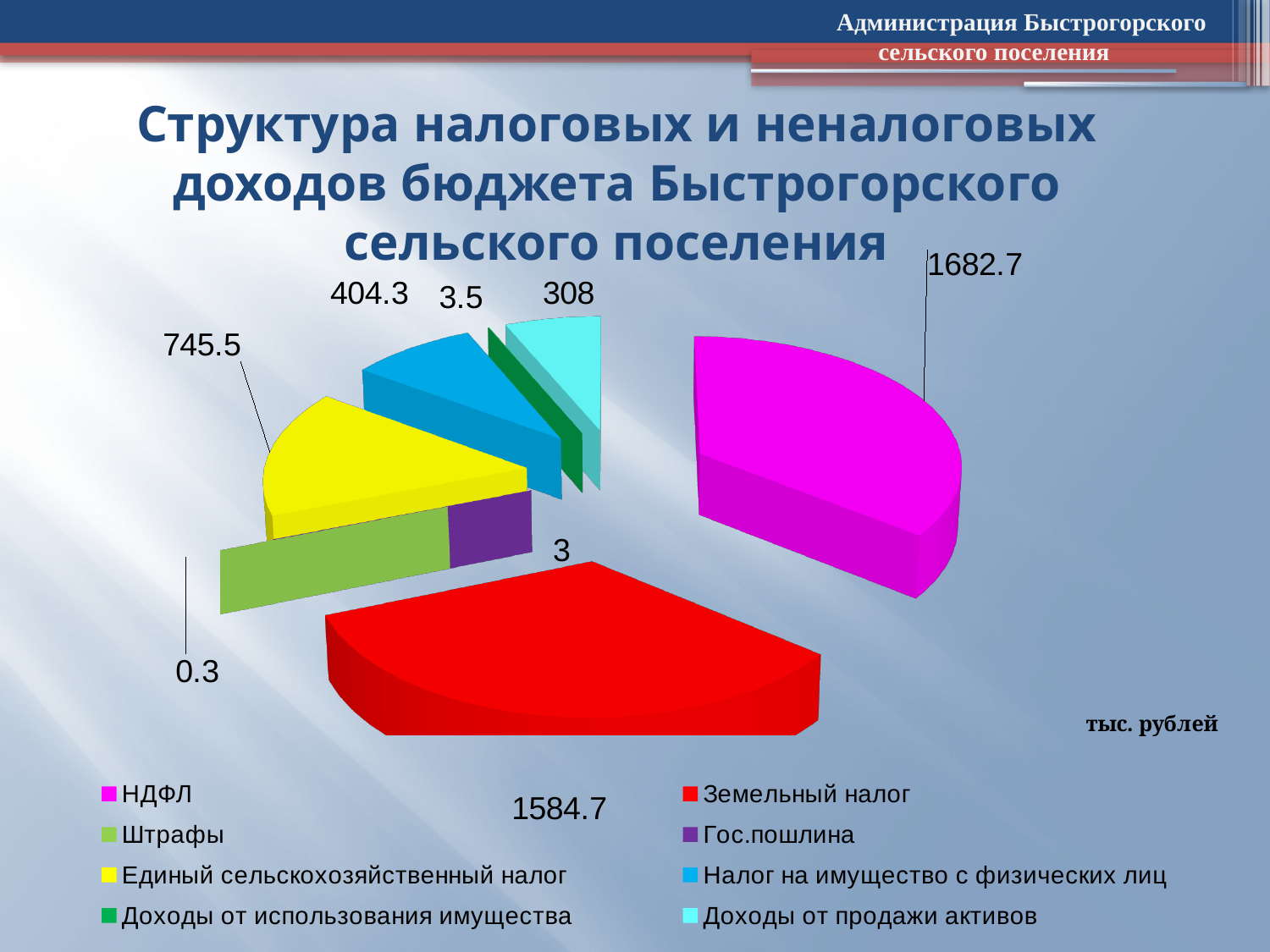
What kind of chart is shown on the slide? pie chart What is the value for Земельный налог? 1584.7 What is the value for НДФЛ? 1682.7 What is the value for Доходы от продажи активов? 308 How many entries does the legend list? 8 Which category has the largest value? НДФЛ What is the value for Единый сельскохозяйственный налог? 745.5 Which category has the smallest value? Штрафы Which is larger, Гос.пошлина or Доходы от использования имущества? Доходы от использования имущества How many slices does the pie chart have? 8 What is the difference between the values for НДФЛ and Земельный налог? 98 What is the value for Налог на имущество с физических лиц? 404.3